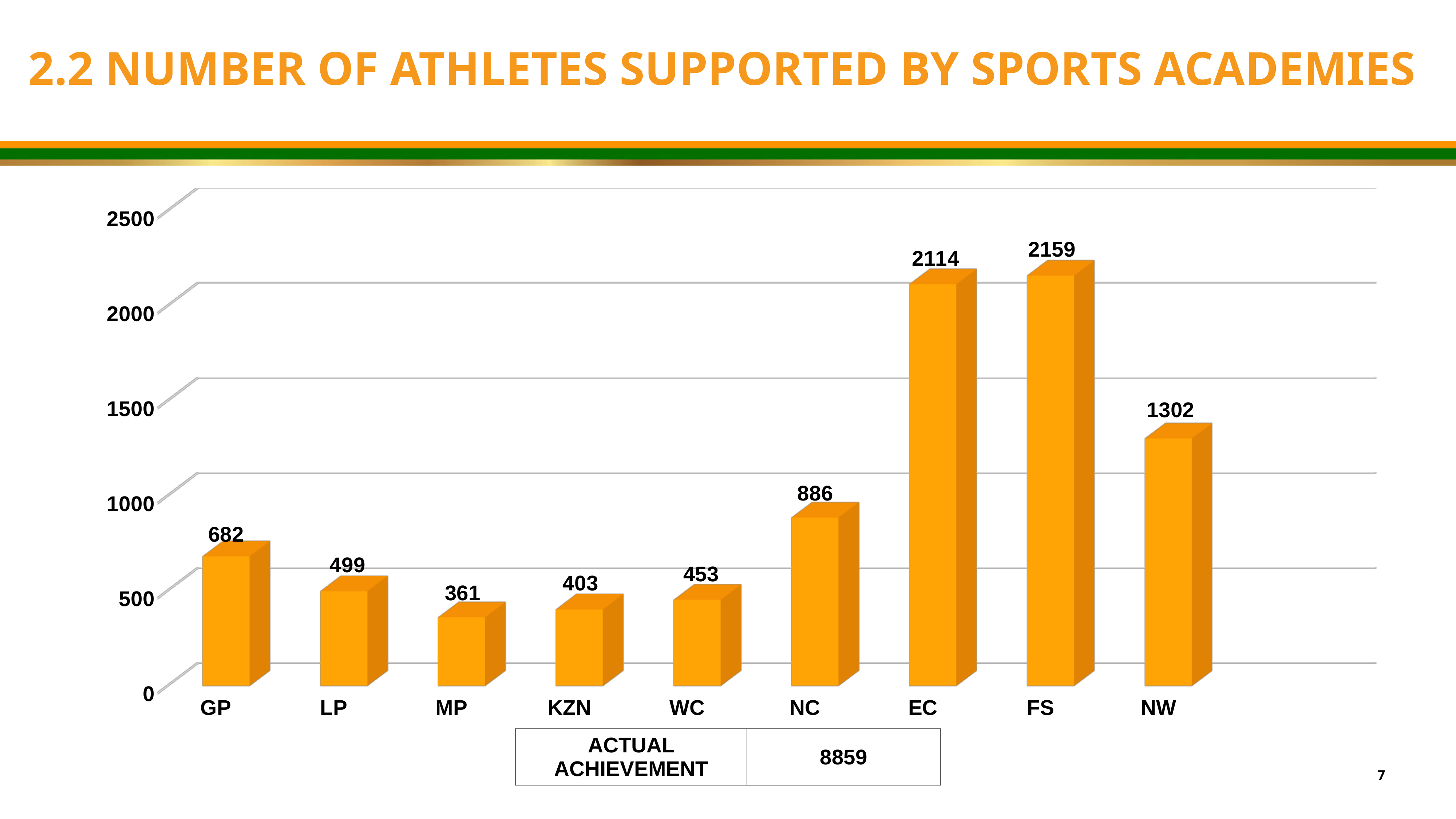
Which province has the highest number of athletes supported? FS How many provinces are shown on the x axis? 9 What is the value shown for NC? 886 Which is larger, the value for WC or the value for KZN? WC What is the difference between the values for FS and EC? 45 What is the number of athletes supported by sports academies in GP? 682 What kind of chart is shown on the slide? bar chart What is the difference between the values for GP and LP? 183 What is the value shown for NW? 1302 Which province has the lowest number of athletes supported? MP Is the value for NW greater or less than 1000? greater What is the actual achievement total shown below the chart? 8859